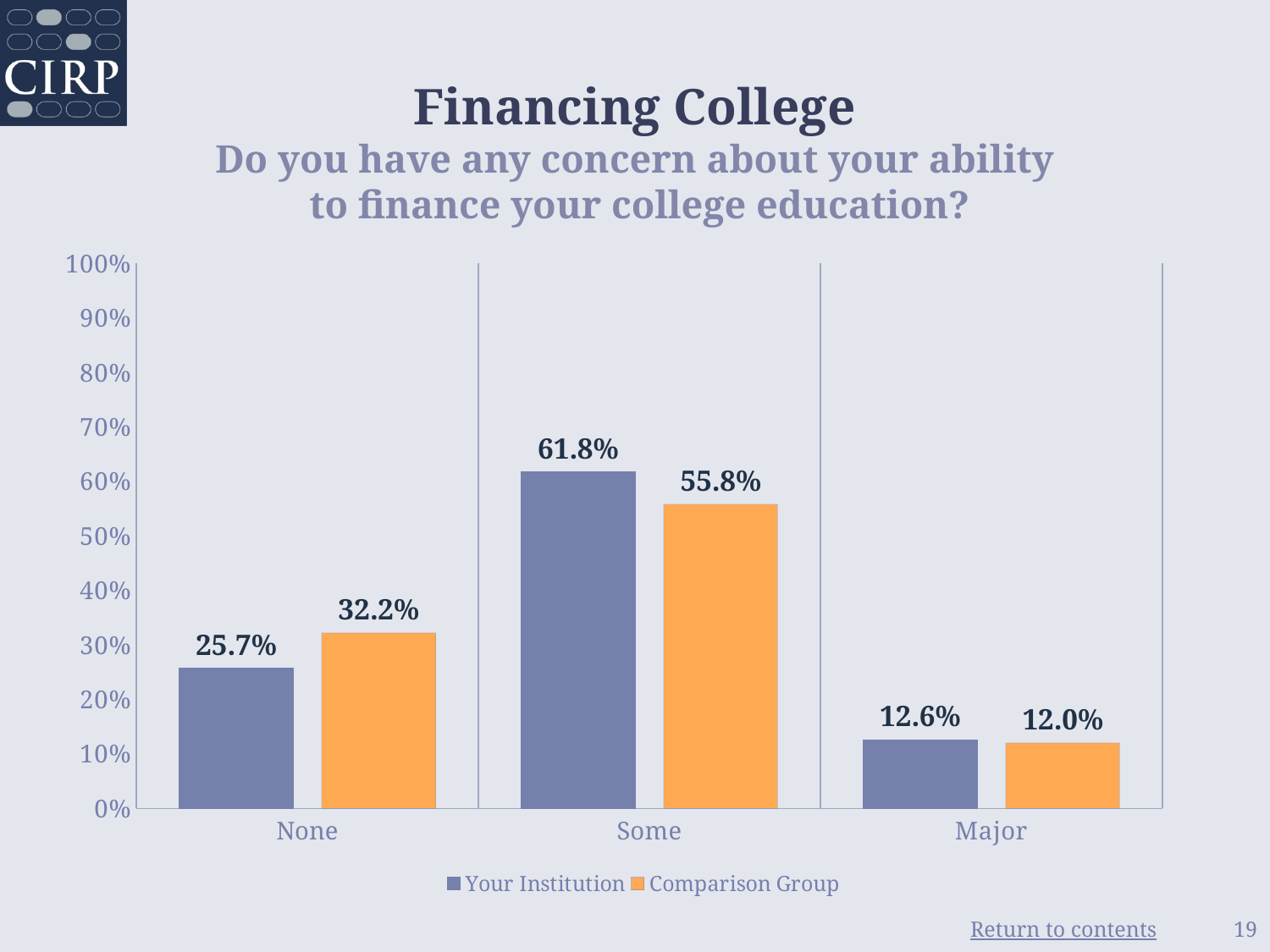
In the None category, which is larger: Your Institution or Comparison Group? Comparison Group What is the value for Your Institution in the None category? 25.7% What is the difference between Your Institution and Comparison Group in the Some category? 6.0% What is the value for Comparison Group in the Some category? 55.8% Which category has the highest value for Your Institution? Some What is the value for Your Institution in the Major category? 12.6% What is the difference between Comparison Group and Your Institution in the None category? 6.5% Which category has the lowest value for Comparison Group? Major What kind of chart is shown on the slide? Bar chart How many categories are shown on the x axis? 3 How many series does the legend list? 2 What is the title of the chart? Financing College